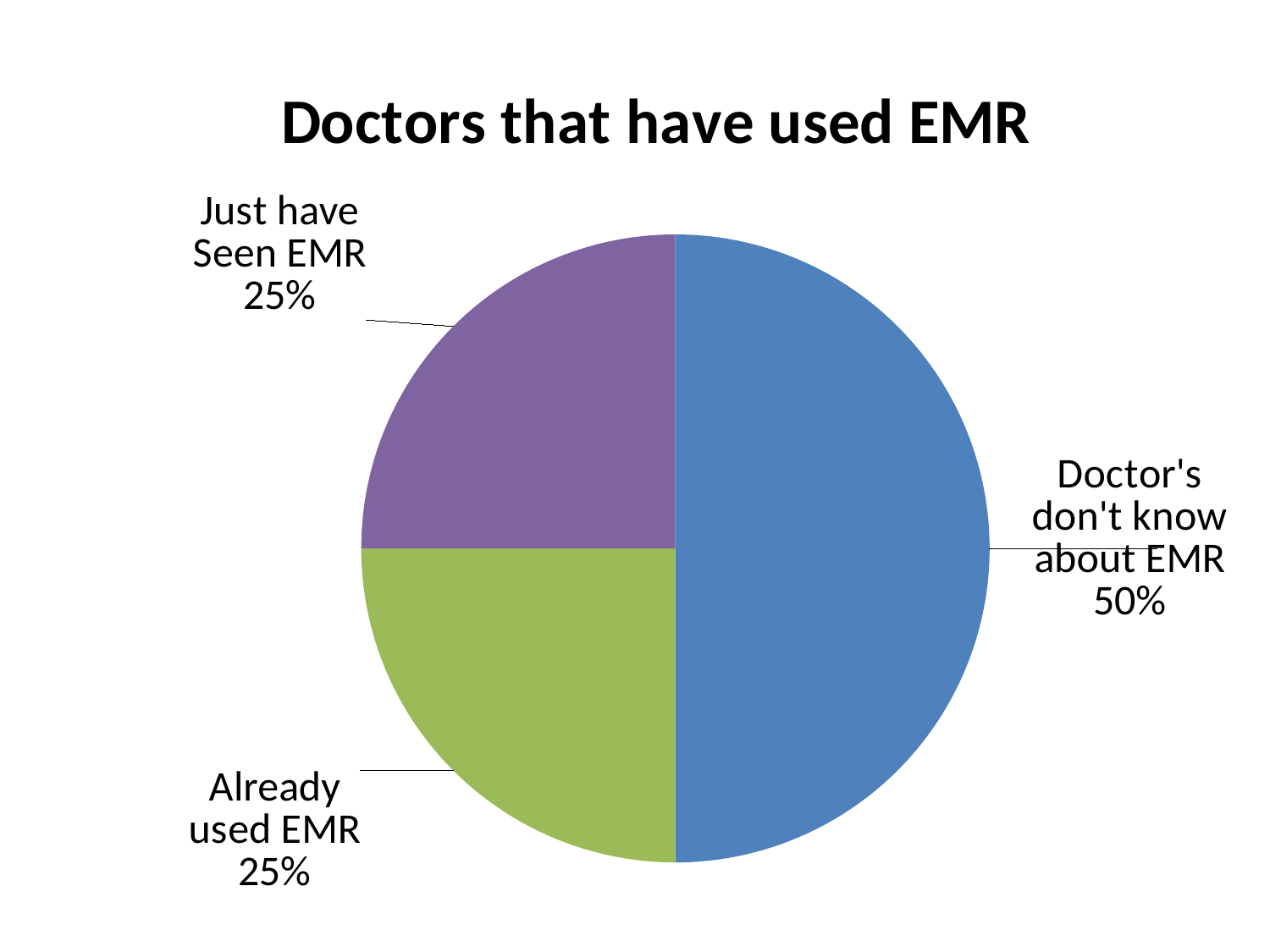
How many slices does the pie chart have? 3 What share of the pie is labelled "Already used EMR"? 25% What is the difference between the share for "Doctor's don't know about EMR" and the share for "Already used EMR"? 25% What is the combined share of "Already used EMR" and "Just have Seen EMR"? 50% What colour is the slice for "Doctor's don't know about EMR"? blue What share of the pie is labelled "Just have Seen EMR"? 25% What kind of chart is shown on the slide? pie chart What is the title of the chart? Doctors that have used EMR What share of the pie is labelled "Doctor's don't know about EMR"? 50% Which is larger: the share for "Doctor's don't know about EMR" or the share for "Just have Seen EMR"? Doctor's don't know about EMR Which slice of the pie is the largest? Doctor's don't know about EMR